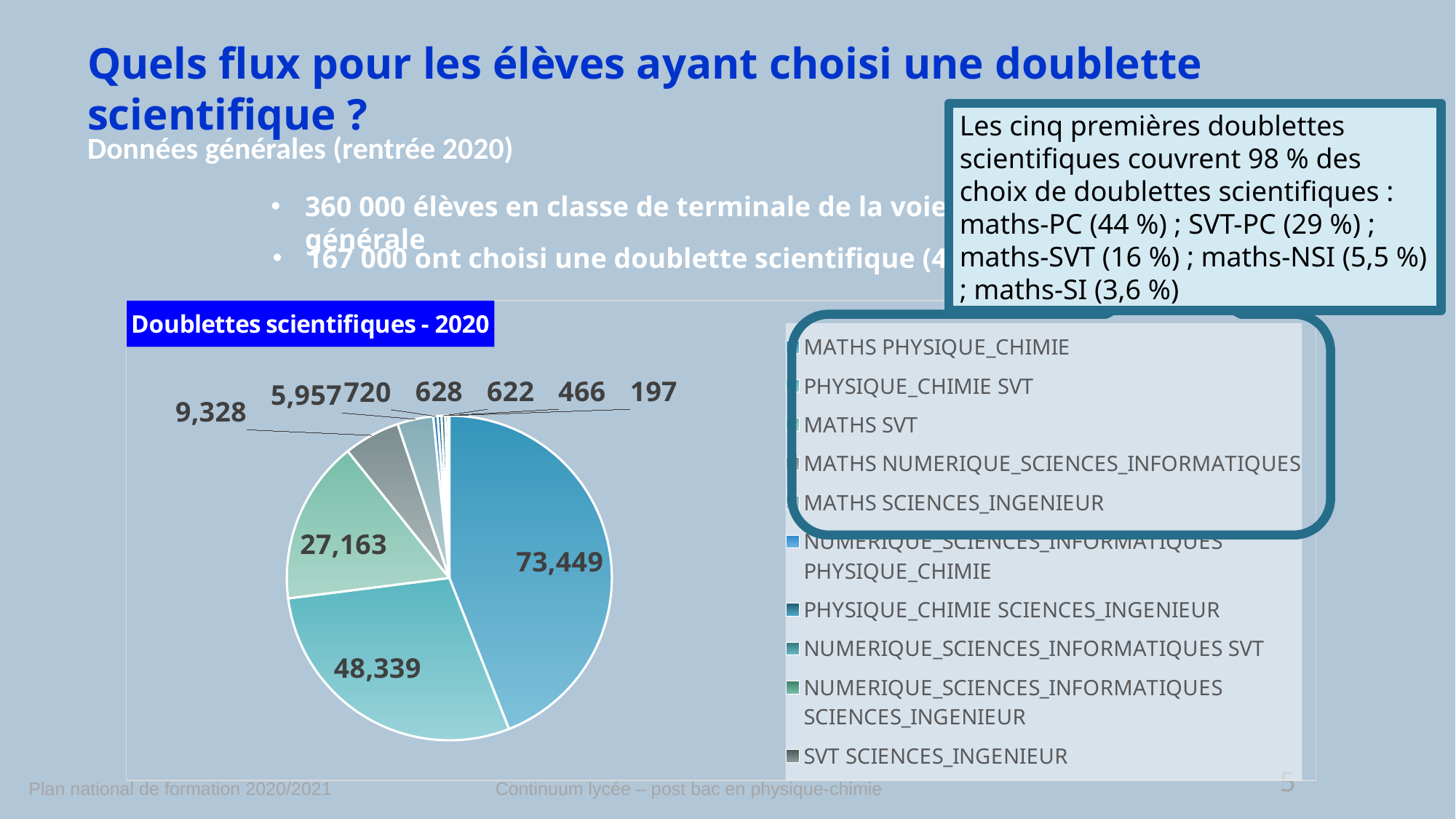
Which is larger, the value for MATHS SVT or the value for MATHS NUMERIQUE_SCIENCES_INFORMATIQUES? MATHS SVT What is the value for MATHS PHYSIQUE_CHIMIE? 73,449 What is the title of the chart? Doublettes scientifiques - 2020 How many categories does the pie chart legend list? 10 What kind of chart is shown on the slide? pie chart What is the value for MATHS SCIENCES_INGENIEUR? 5,957 What is the value for MATHS SVT? 27,163 Which category has the largest slice of the pie? MATHS PHYSIQUE_CHIMIE What is the value for MATHS NUMERIQUE_SCIENCES_INFORMATIQUES? 9,328 What is the value for PHYSIQUE_CHIMIE SVT? 48,339 What is the smallest value labelled on the pie chart? 197 What is the difference between the values for MATHS PHYSIQUE_CHIMIE and PHYSIQUE_CHIMIE SVT? 25,110